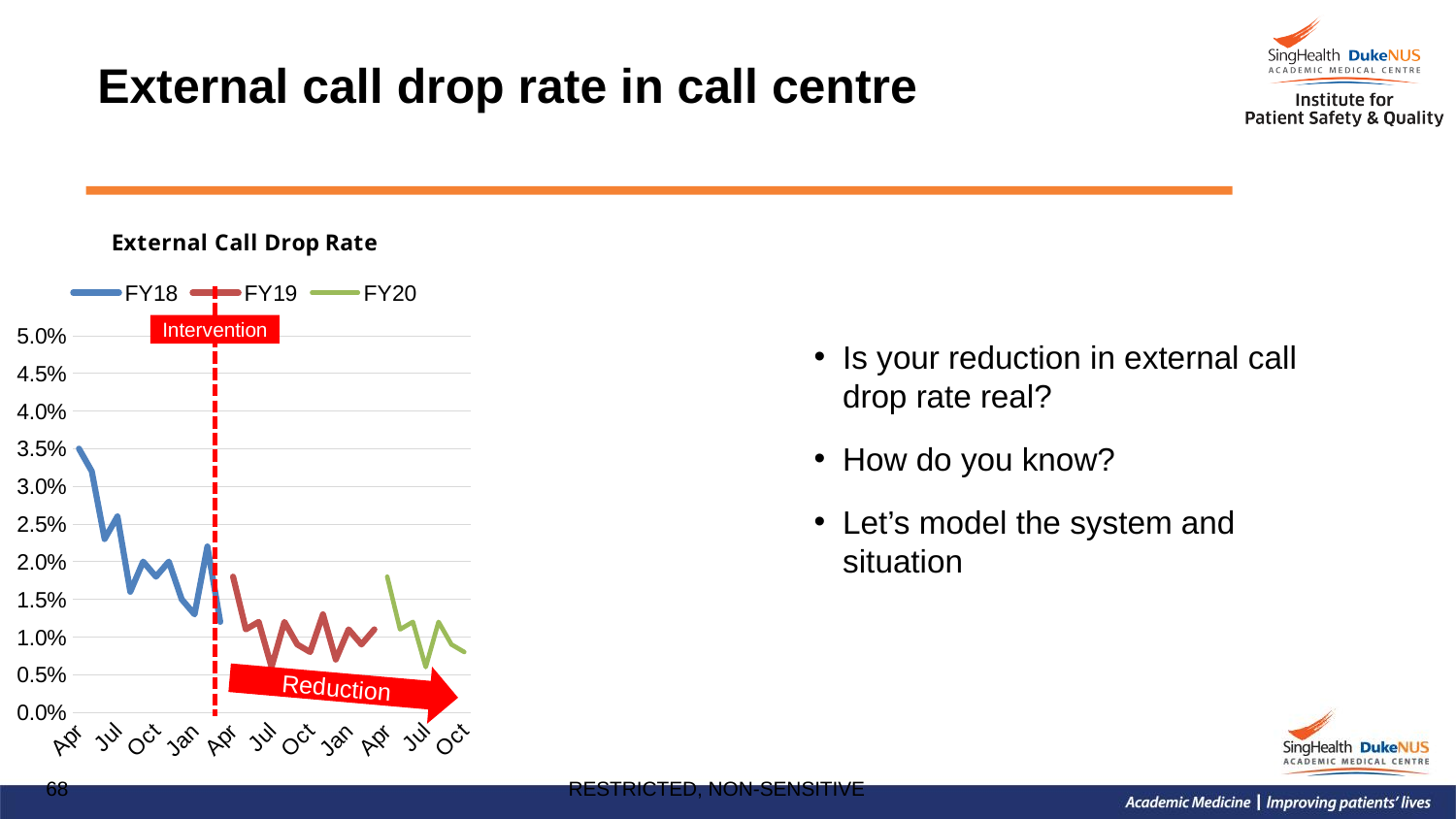
Is the highest FY19 value greater or less than 2.0%? less Is the first FY18 value (Apr) greater or less than 3.0%? greater Is the first FY20 value greater or less than 1.5%? greater Which series has the higher starting value, FY18 or FY19? FY18 What kind of chart is shown on the slide? Line chart What does the red dashed vertical line on the chart mark? Intervention What is the title of the chart on the slide? External Call Drop Rate How many series does the legend of the External Call Drop Rate chart list? 3 How many month labels are shown along the x axis? 11 Does the FY18 line generally rise or fall from Apr to the end of the year? Fall Which series reaches the highest call drop rate on the chart? FY18